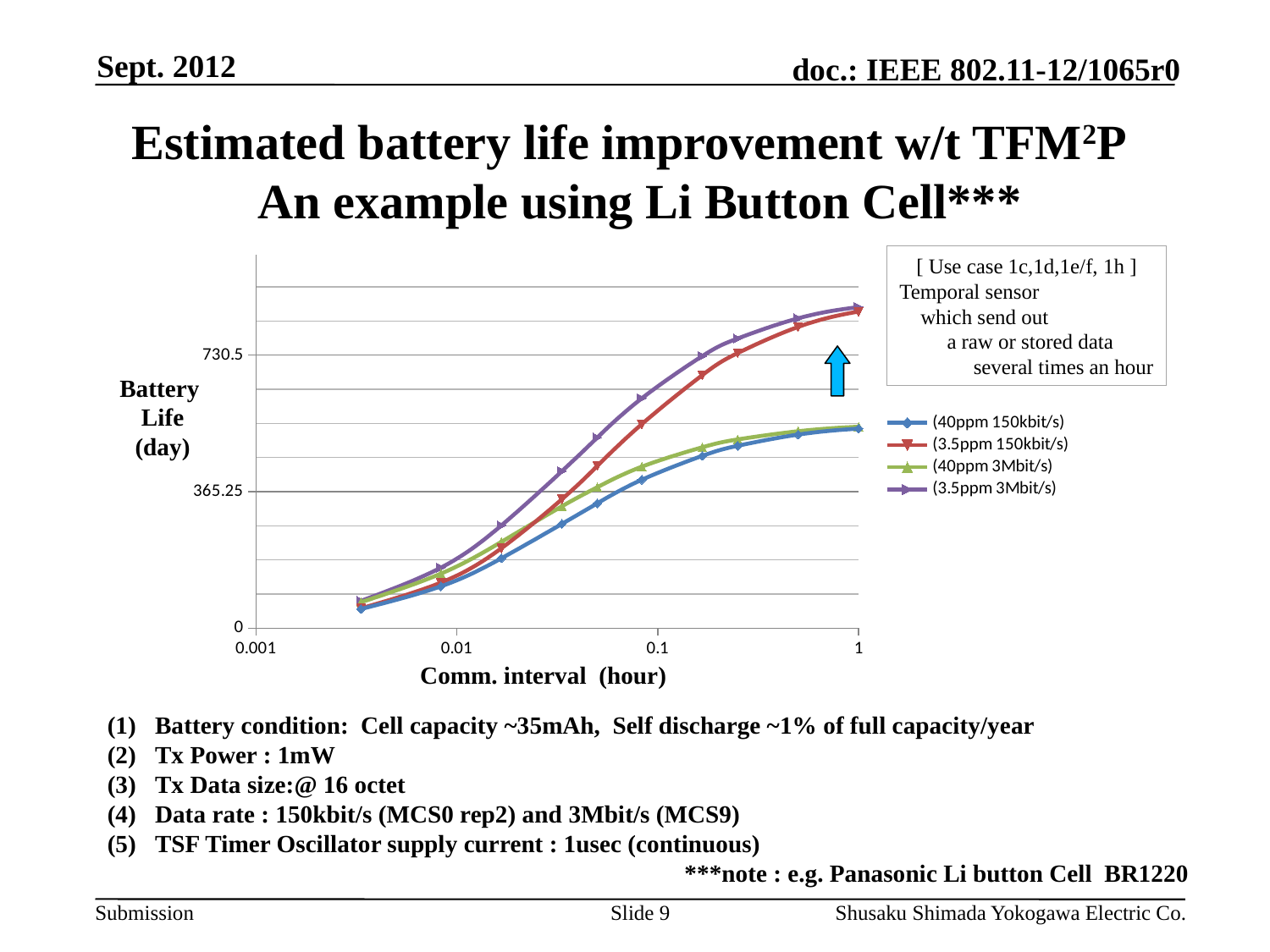
Do the battery life values rise or fall as the communication interval increases along the x axis? rise Is the value for (40ppm 150kbit/s) at a comm. interval of 1 hour greater or less than 730.5? less Is the value for (3.5ppm 3Mbit/s) at a comm. interval of 1 hour greater or less than 730.5? greater How many series does the chart legend list? 4 Is the value for (3.5ppm 3Mbit/s) at a comm. interval of 0.01 hour greater or less than 365.25? less What is the title of the x axis of the chart? Comm. interval (hour) What is the label on the y axis of the chart? Battery Life (day) At a comm. interval of 0.1 hour, which series has the larger value: (3.5ppm 150kbit/s) or (40ppm 3Mbit/s)? (3.5ppm 150kbit/s) What kind of chart is shown on the slide? line chart At a comm. interval of 1 hour, which series has the larger value: (3.5ppm 3Mbit/s) or (40ppm 150kbit/s)? (3.5ppm 3Mbit/s) How many tick labels are shown on the x axis of the chart? 4